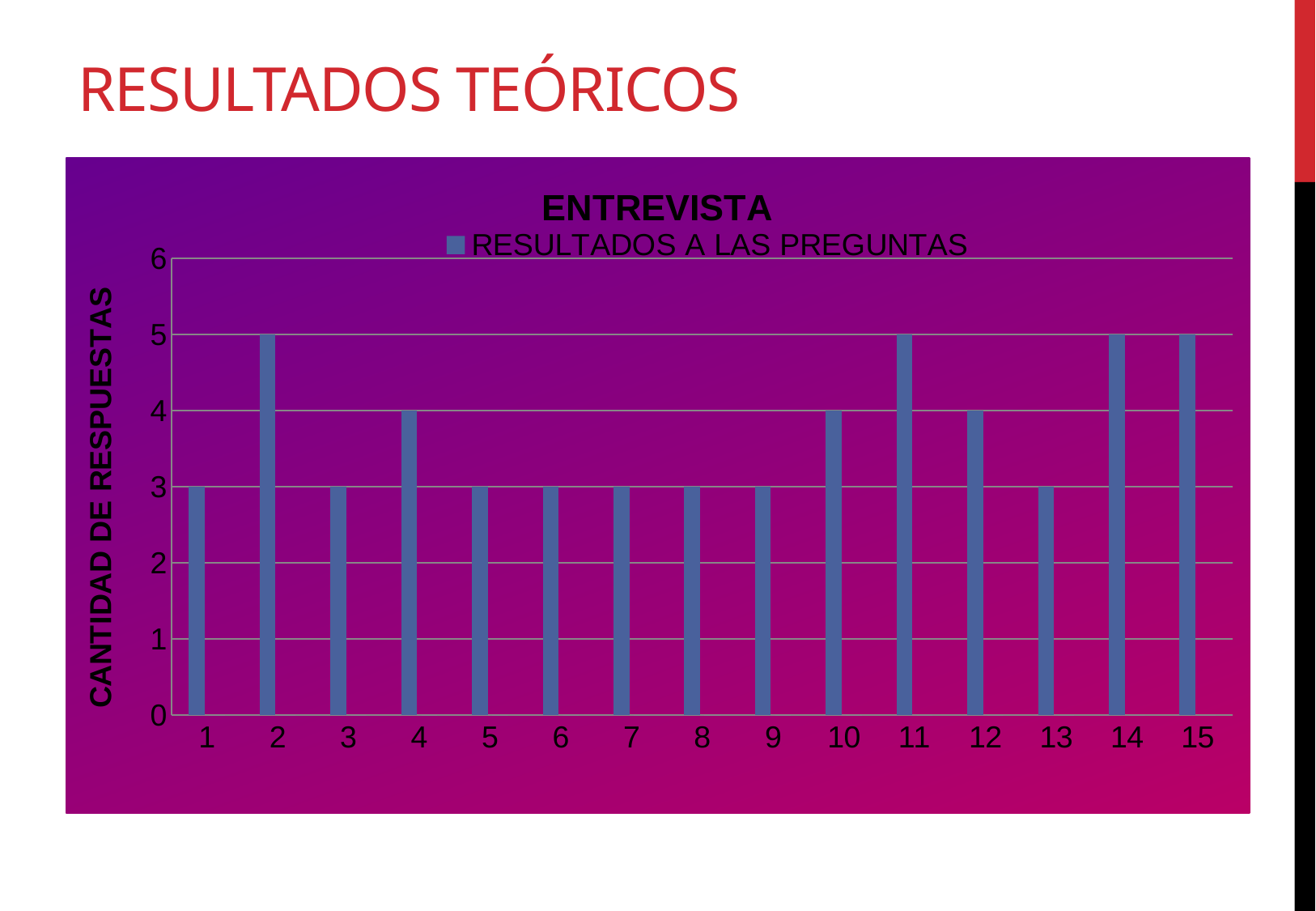
What type of chart is shown on the slide? bar chart Which has a larger value, category 11 or category 13? 11 What is the value for category 12? 4 How many series does the legend list? 1 What is the value for category 4? 4 What is the title of the chart? ENTREVISTA What is the label on the vertical axis of the chart? CANTIDAD DE RESPUESTAS What is the value for category 2? 5 What is the highest value reached by any bar in the chart? 5 What is the value for category 7? 3 How many categories are shown on the x axis? 15 What is the difference between the values for category 2 and category 1? 2